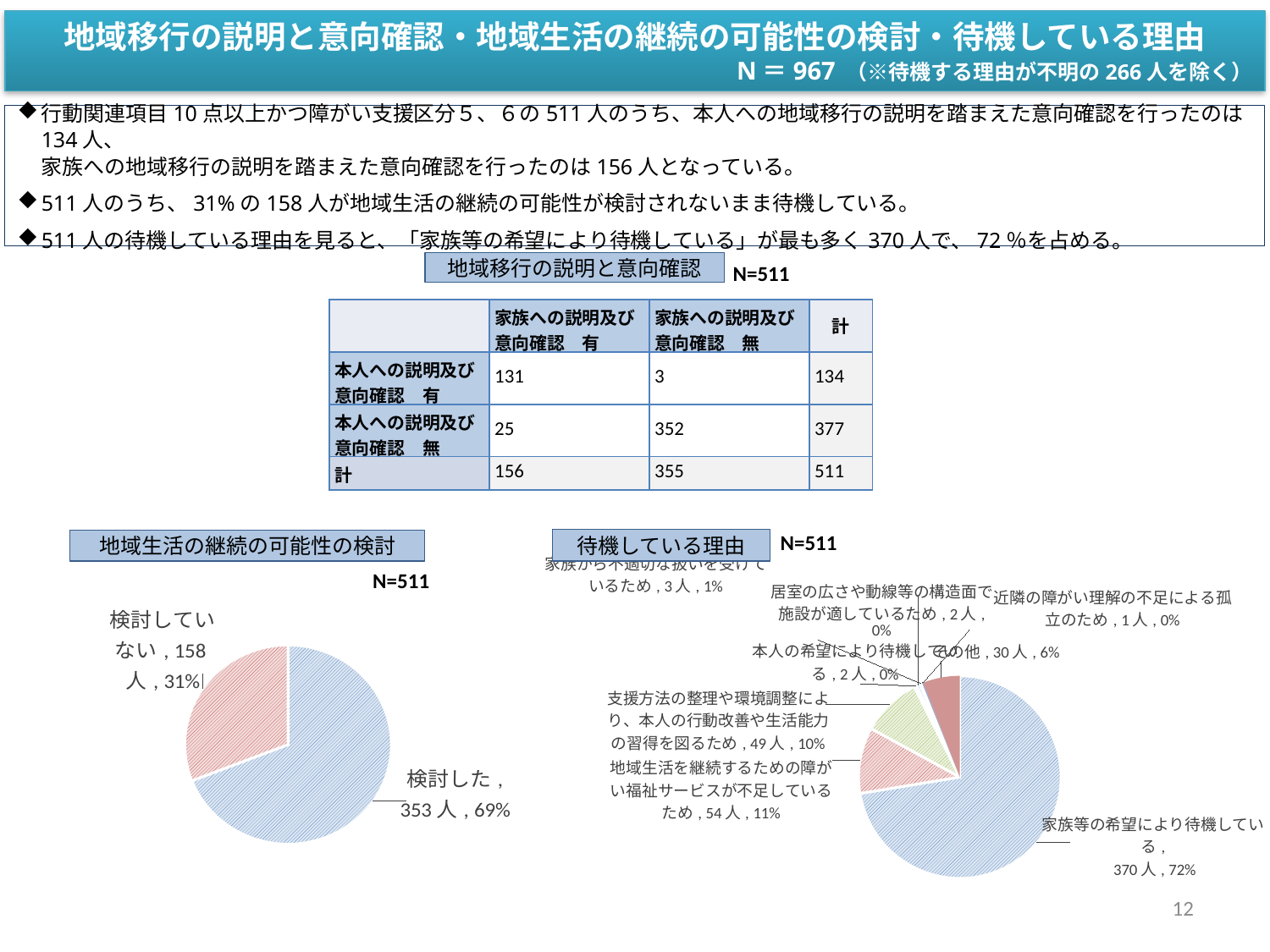
「地域生活の継続の可能性の検討」の円グラフで、「検討した」の人数は何人ですか？ 353人 「待機している理由」の円グラフで、「地域生活を継続するための障がい福祉サービスが不足しているため」の人数は何人ですか？ 54人 「待機している理由」の円グラフで、「支援方法の整理や環境調整により、本人の行動改善や生活能力の習得を図るため」と「地域生活を継続するための障がい福祉サービスが不足しているため」では、どちらの人数が多いですか？ 地域生活を継続するための障がい福祉サービスが不足しているため 「地域生活の継続の可能性の検討」の円グラフで、「検討していない」の割合は何%ですか？ 31% 「待機している理由」の円グラフで、最も少ない理由は何ですか？ 近隣の障がい理解の不足による孤立のため 「地域生活の継続の可能性の検討」のグラフはどの種類のグラフですか？ 円グラフ 「地域生活の継続の可能性の検討」の円グラフで、「検討した」と「検討していない」の人数の差は何人ですか？ 195人 「待機している理由」の円グラフで、最も多い理由は何ですか？ 家族等の希望により待機している 「待機している理由」の円グラフで、「その他」の割合は何%ですか？ 6% 「待機している理由」の円グラフのNはいくつですか？ N=511 「待機している理由」の円グラフには、いくつの理由（区分）がありますか？ 8 「待機している理由」の円グラフで、「家族等の希望により待機している」の人数は何人ですか？ 370人